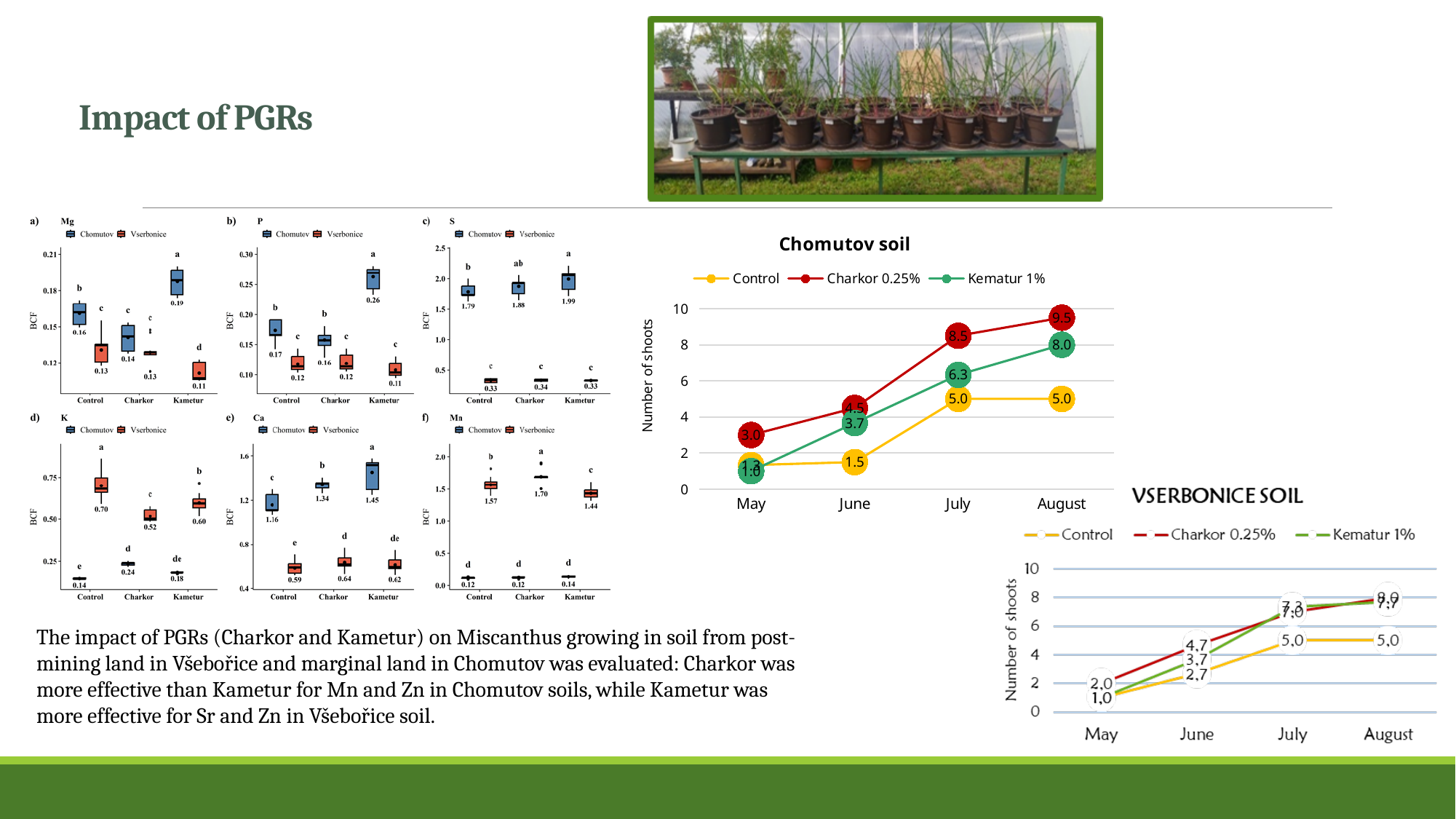
In the Chomutov soil chart, what is the number of shoots for Kematur 1% in July? 6.3 In box plot d) K, which treatment has the highest labelled BCF value for Vserbonice? Control In the Chomutov soil chart, how many series does the legend list? 3 In the Vserbonice soil chart, which series has the lowest number of shoots in June? Control In the Chomutov soil chart, which series has the highest number of shoots in August? Charkor 0.25% In the Chomutov soil chart, what is the number of shoots for Charkor 0.25% in August? 9.5 In the Vserbonice soil chart, how many months are shown on the x axis? 4 In the Chomutov soil chart, does the number of shoots for Kematur 1% rise or fall from May to August? Rise In box plot c) S, what is the labelled BCF value for Chomutov under Kametur? 1.99 In the Chomutov soil chart, what is the difference between Charkor 0.25% and Control in July? 3.5 What kind of chart is the Chomutov soil chart? Line chart In the Vserbonice soil chart, what is the number of shoots for Charkor 0.25% in June? 4.7